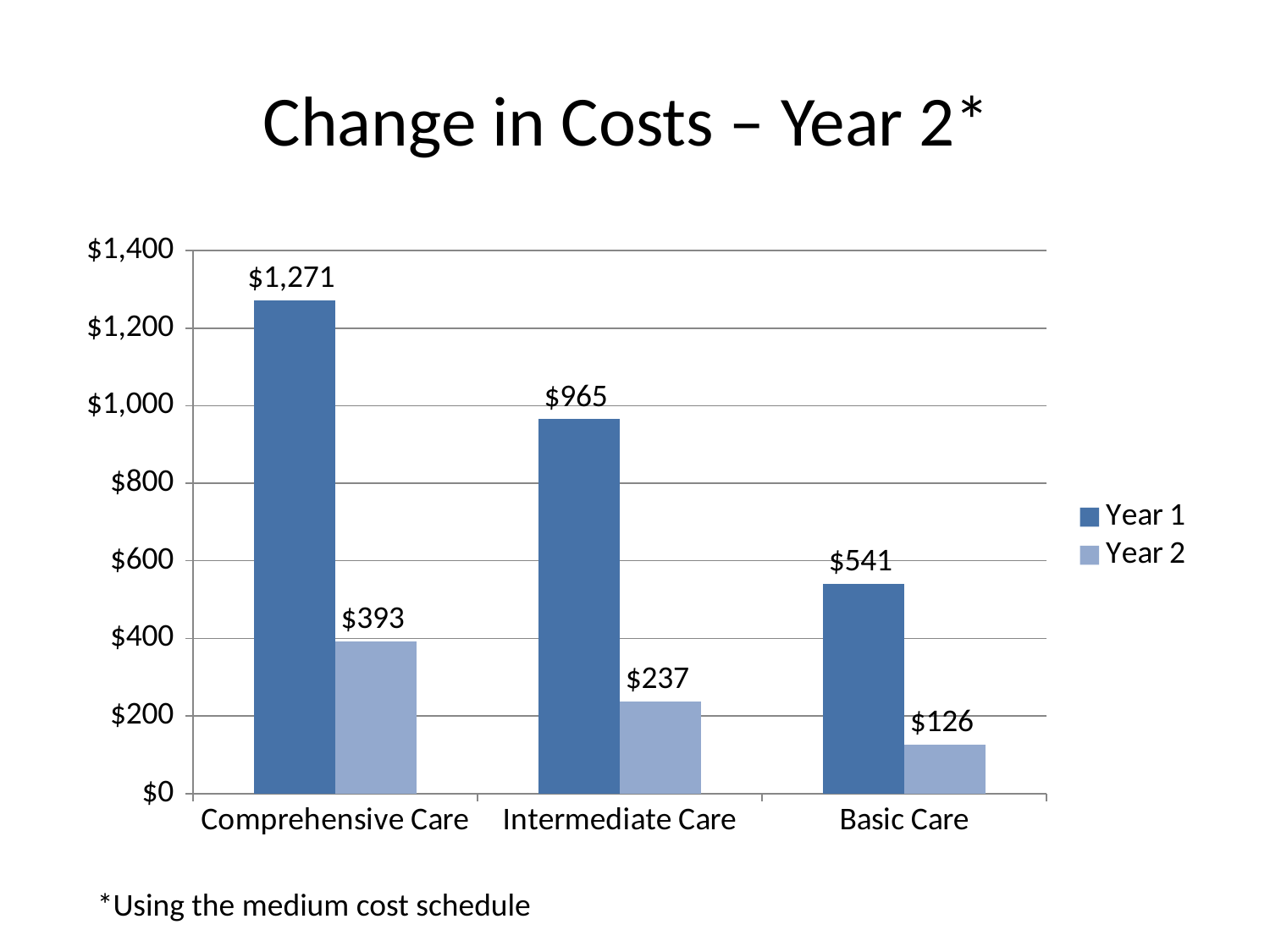
What kind of chart is shown on the slide? Bar chart Which care level has the lowest Year 2 cost? Basic Care How many care levels are shown on the x axis? 3 What is the Year 1 cost for Comprehensive Care? $1,271 What is the Year 2 cost for Basic Care? $126 What is the difference between the Year 1 costs for Intermediate Care and Basic Care? $424 What is the Year 2 cost for Intermediate Care? $237 What is the title of the chart? Change in Costs – Year 2* What is the difference between the Year 1 and Year 2 costs for Comprehensive Care? $878 How many series does the legend list? 2 Which is larger: the Year 2 cost for Comprehensive Care or the Year 1 cost for Basic Care? Year 1 cost for Basic Care Which care level has the highest Year 1 cost? Comprehensive Care